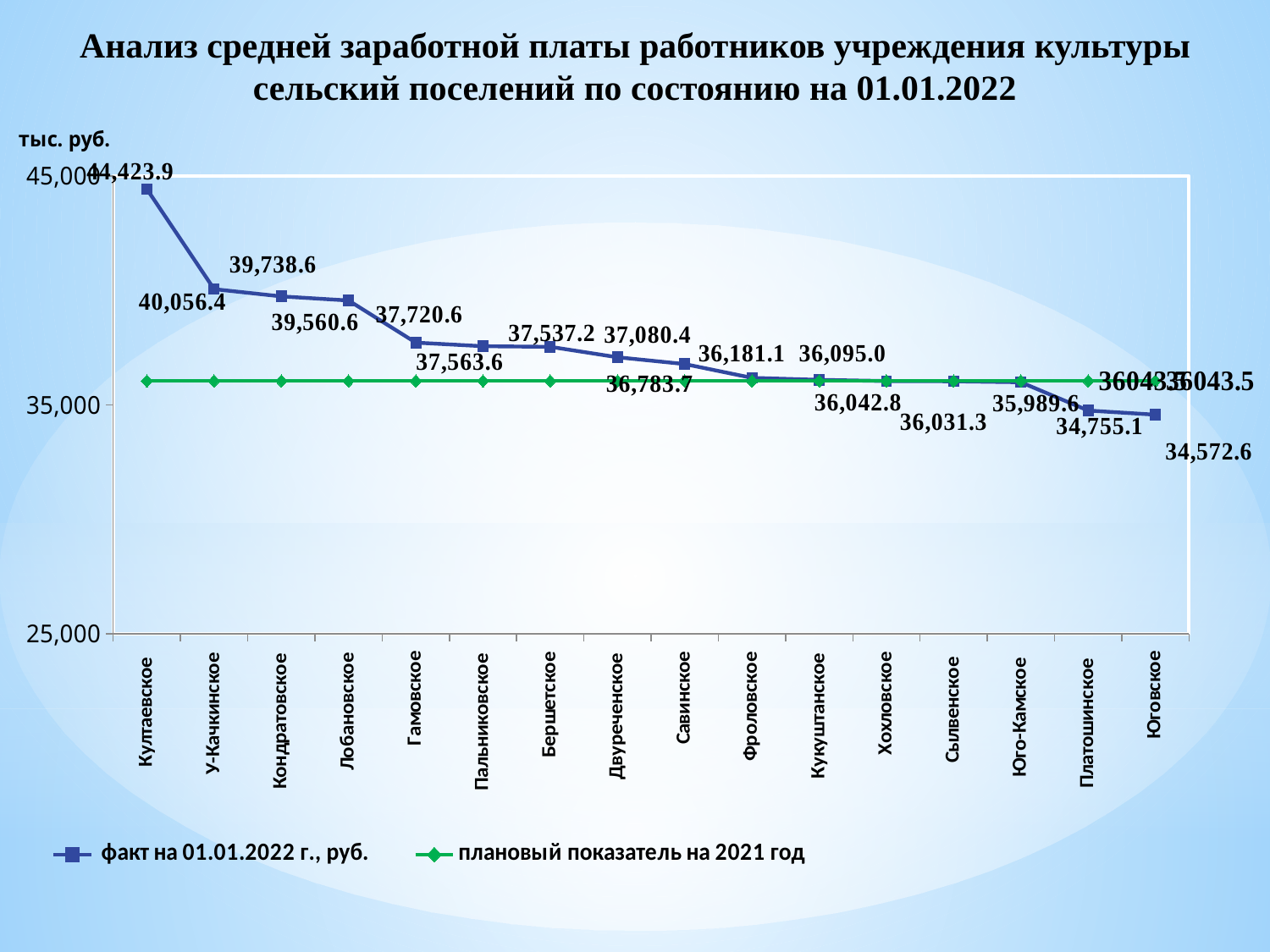
What is the actual average salary (факт на 01.01.2022) for Култаевское? 44,423.9 How many settlements (categories) are plotted along the x axis? 16 Which settlement has the highest actual average salary? Култаевское What is the difference between the actual average salary for Култаевское and for Юговское? 9,851.3 Do the actual salary values rise or fall moving from left to right along the x axis? fall What is the actual average salary (факт на 01.01.2022) for Платошинское? 34,755.1 What is the name of the series shown with the green line? плановый показатель на 2021 год What type of chart is shown on the slide? line chart What is the actual average salary (факт на 01.01.2022) for Юговское? 34,572.6 Is the actual average salary for Юговское greater or less than 35,000? less How many series does the legend list? 2 Which settlement has the lowest actual average salary? Юговское